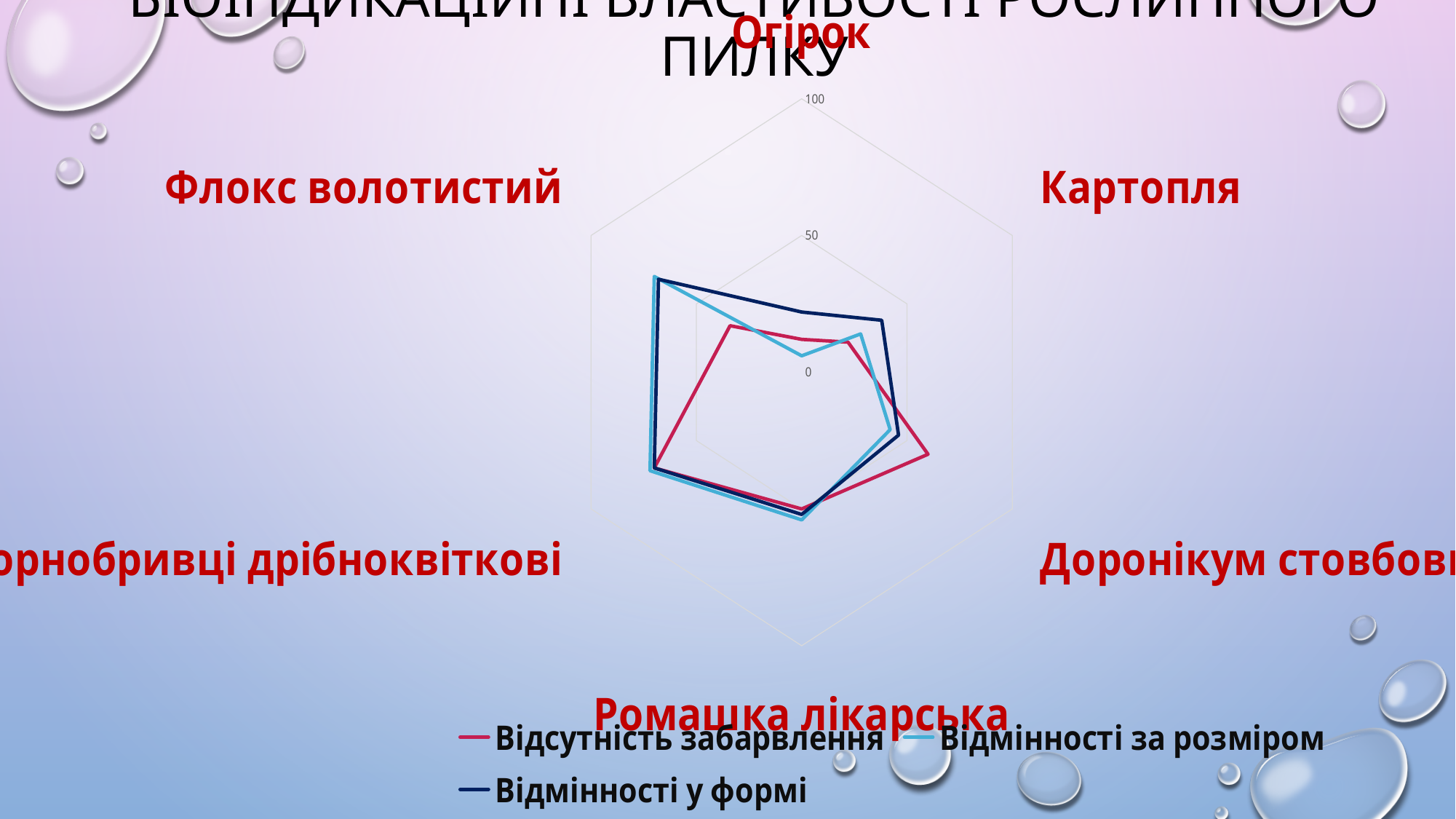
How many categories (axes) does the radar chart have? 6 For Флокс волотистий, which series has the larger value: Відсутність забарвлення or Відмінності за розміром? Відмінності за розміром What kind of chart is shown on the slide? Radar chart For Огірок, which series has the larger value: Відмінності у формі or Відмінності за розміром? Відмінності у формі Which series is drawn in light blue according to the legend? Відмінності за розміром Is the value of Відмінності за розміром for Флокс волотистий greater or less than 50? greater How many series does the legend list? 3 Is the value of Відсутність забарвлення for Картопля greater or less than 50? less Is the value of Відмінності у формі for Огірок greater or less than 50? less For the series Відмінності за розміром, which category has the lowest value? Огірок What is the highest value shown on the radial axis? 100